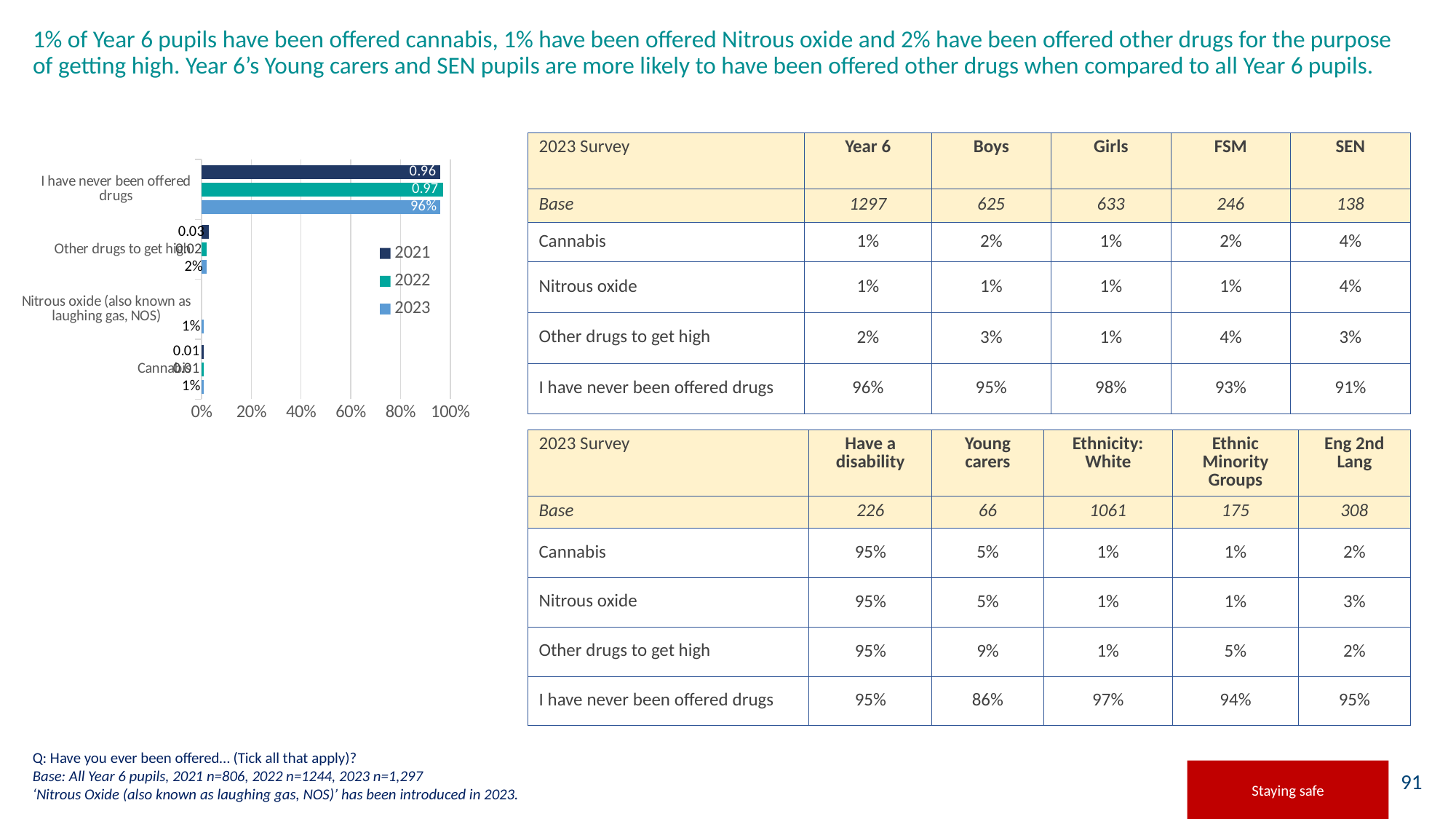
Which category has the highest 2023 value in the chart? I have never been offered drugs What is the 2021 value for 'Other drugs to get high' in the chart? 0.03 What is the 2023 value for 'Nitrous oxide (also known as laughing gas, NOS)' in the chart? 1% What is the 2022 value for 'I have never been offered drugs' in the chart? 0.97 How many categories are plotted on the chart? 4 What is the 2023 value for 'I have never been offered drugs' in the chart? 96% Which series does the chart's legend list first? 2021 Is the 2023 value for 'I have never been offered drugs' greater or less than 80%? greater How many series does the chart's legend list? 3 What is the 2021 value for 'I have never been offered drugs' in the chart? 0.96 What kind of chart is shown on the slide? bar chart What is the 2023 value for 'Other drugs to get high' in the chart? 2%